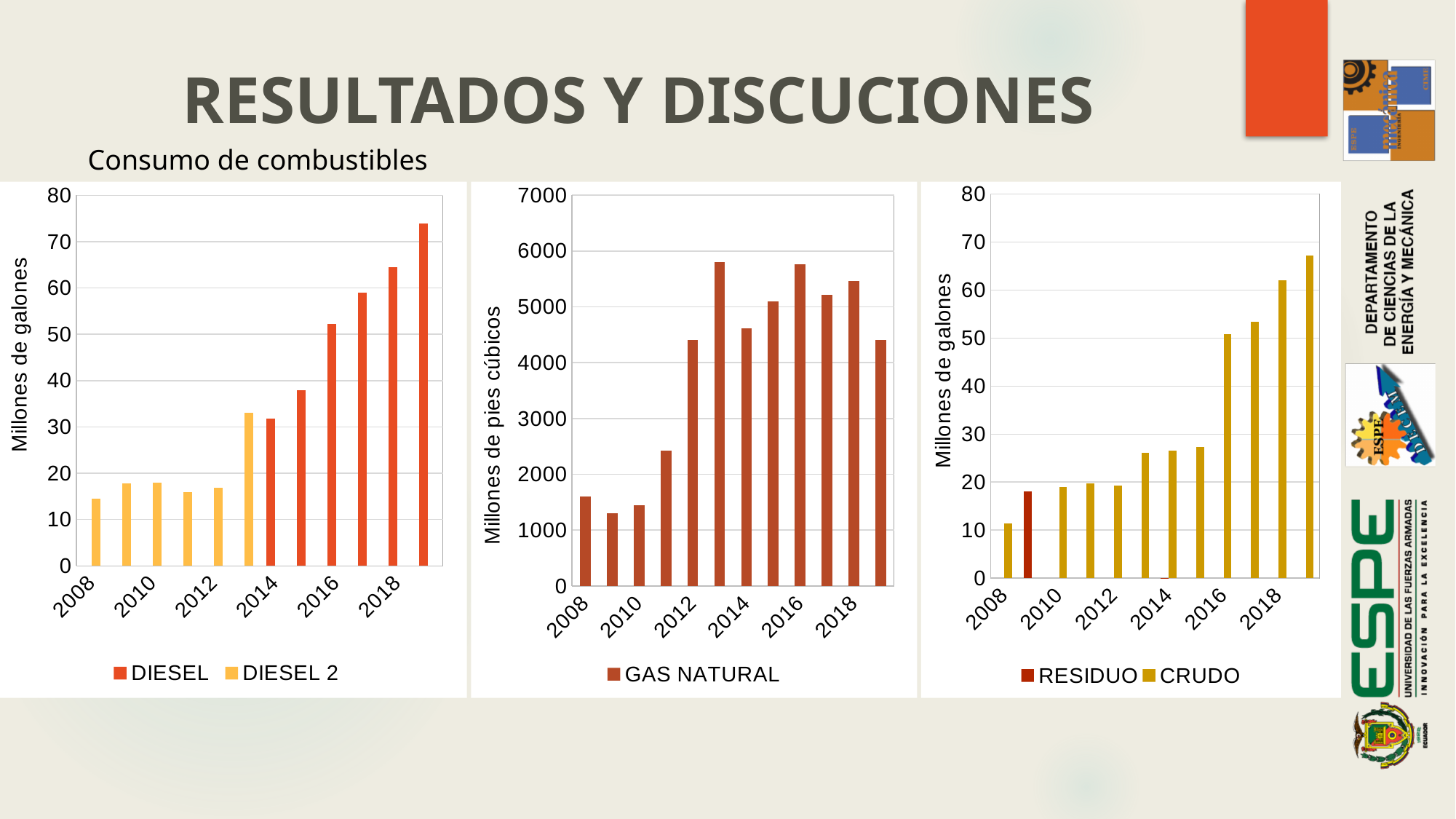
In the middle chart (GAS NATURAL), is the value for 2009 greater or less than 2000? less In the right chart (RESIDUO / CRUDO), which year has the larger value, 2015 or 2016? 2016 How many bars are plotted in the middle chart (GAS NATURAL)? 12 How many series does the legend of the left chart list? 2 What kind of chart is the left chart (DIESEL / DIESEL 2)? bar chart In the left chart, do the values generally rise or fall from 2013 to 2019? rise What is the y-axis label of the middle chart (GAS NATURAL)? Millones de pies cúbicos In the right chart (RESIDUO / CRUDO), which year has the highest value? 2019 In the middle chart (GAS NATURAL), is the value for 2013 greater or less than 5000? greater In the left chart, is the value for 2019 greater or less than 70? greater In the left chart, which year has the highest value? 2019